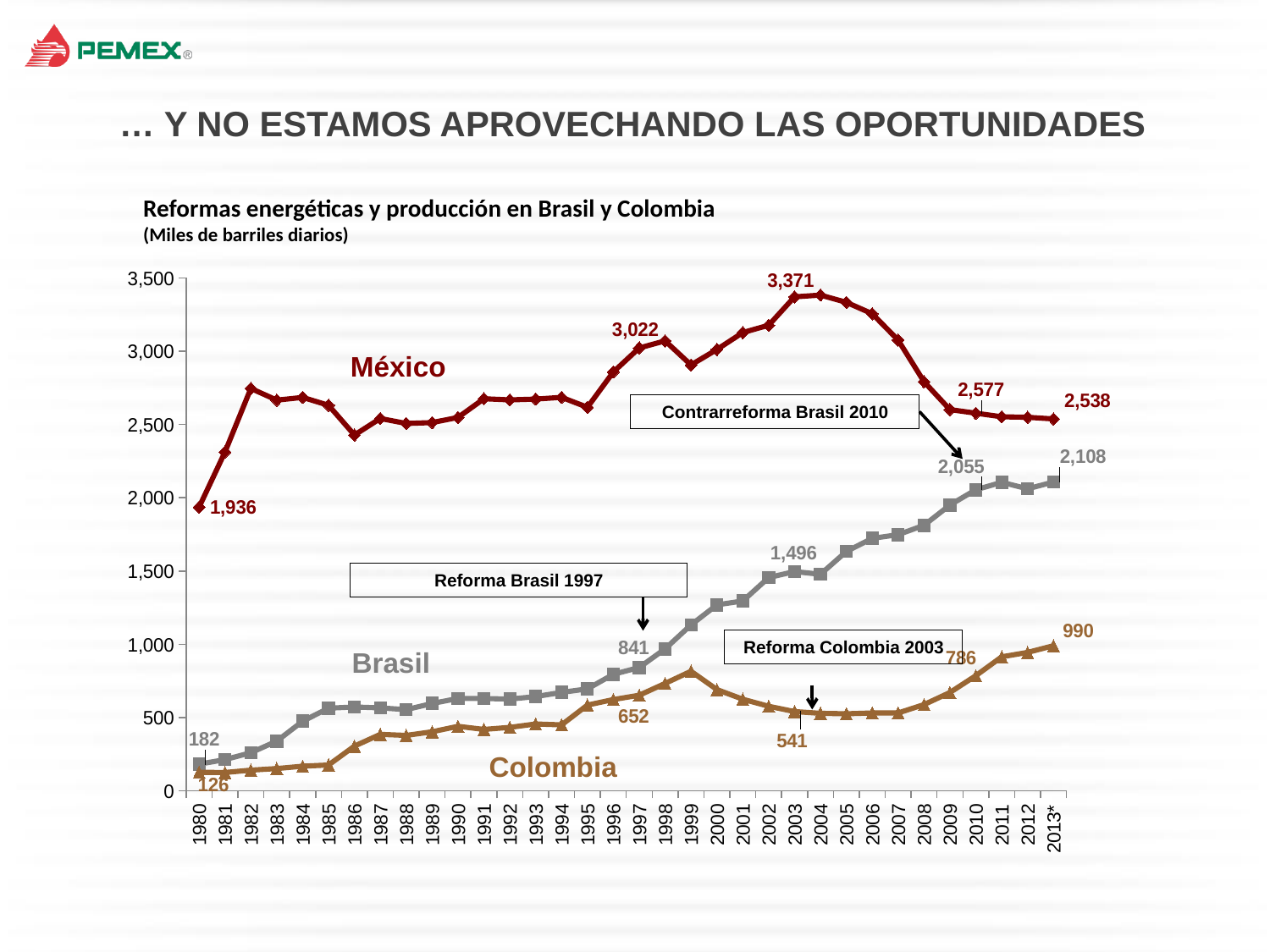
What value is labelled for Brasil in 2013*? 2,108 What was México's production in 1980, in thousands of barrels per day? 1,936 What kind of chart is shown on the slide? line chart What is the difference between México's 2003 value (3,371) and its 2013* value (2,538)? 833 Is México's value in 1982 greater or less than 2,500? greater How many countries (series) are plotted on the chart? 3 By how much did Brasil's production increase from 1980 (182) to 2013* (2,108)? 1,926 What is the overall trend of Brasil's production from 1980 to 2013*? rising Which country had the lowest production in 1980? Colombia In 2010, which was larger: Brasil's production or Colombia's production? Brasil What value is labelled for Colombia in 2003? 541 What is the highest labelled value for México, and in which year does it occur? 3,371 in 2003